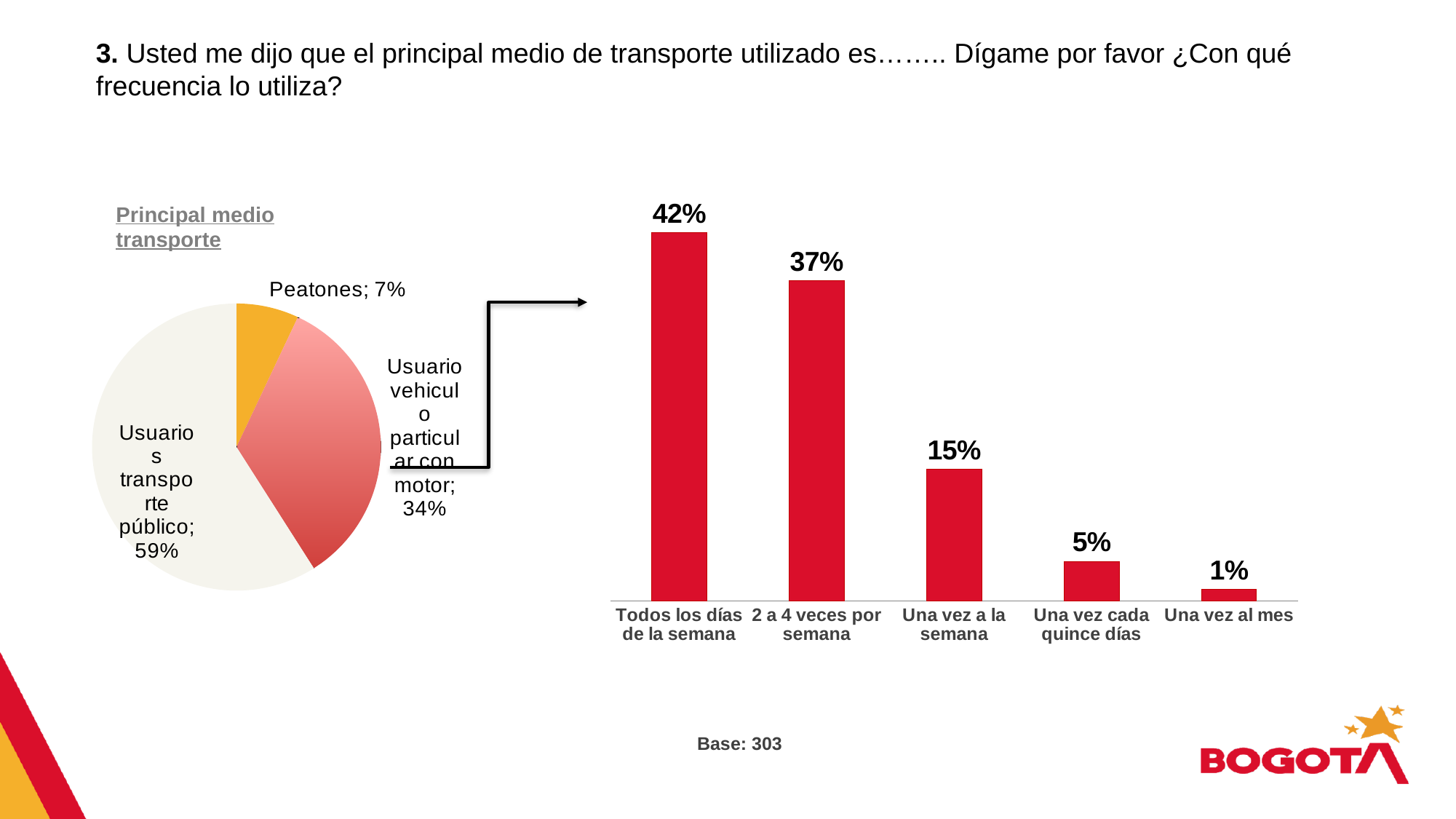
In the pie chart titled 'Principal medio transporte', what is the share for 'Usuarios transporte público'? 59% In the bar chart on the right, do the values rise or fall from left to right? fall In the bar chart on the right, which is larger: 'Una vez a la semana' or 'Una vez cada quince días'? Una vez a la semana In the bar chart on the right, how many categories are shown? 5 In the pie chart titled 'Principal medio transporte', how many slices are there? 3 In the pie chart titled 'Principal medio transporte', what is the share for 'Peatones'? 7% In the pie chart titled 'Principal medio transporte', which slice is the largest? Usuarios transporte público In the pie chart titled 'Principal medio transporte', what is the share for 'Usuario vehiculo particular con motor'? 34% In the bar chart on the right, which category has the lowest value? Una vez al mes In the bar chart on the right, what is the value for 'Todos los días de la semana'? 42% In the bar chart on the right, what is the value for 'Una vez cada quince días'? 5% In the bar chart on the right, what is the difference between 'Todos los días de la semana' and '2 a 4 veces por semana'? 5%